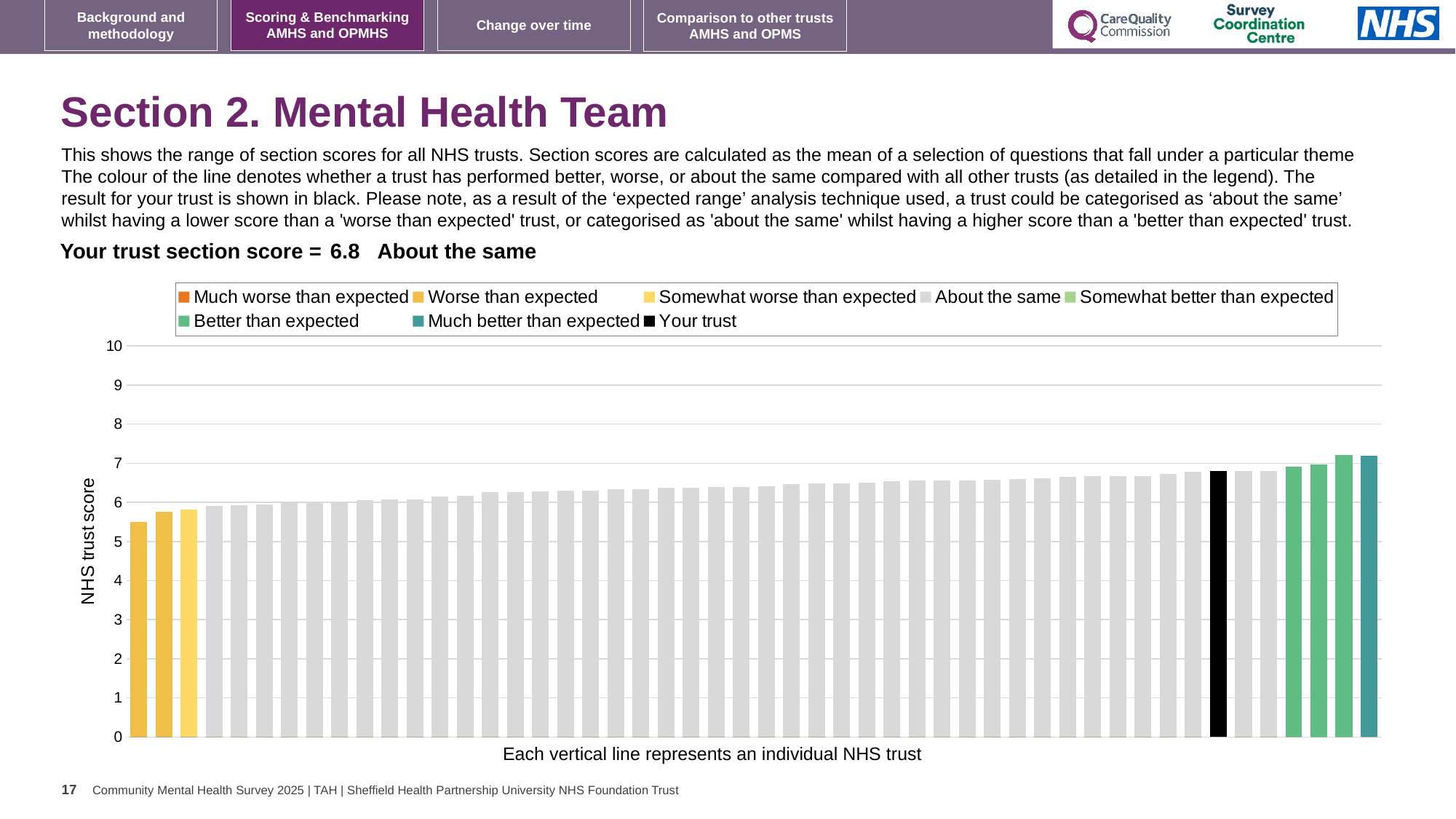
Is the value of the highest bar in the chart greater or less than 7? greater How many bars are coloured as 'Much better than expected'? 1 What is the label on the y axis of the chart? NHS trust score How many bars are coloured as 'Worse than expected'? 2 Is the value of the lowest bar in the chart greater or less than 6? less Which category is your trust placed in for this section? About the same How many entries does the chart legend list? 8 What kind of chart is shown on the slide? bar chart Is the value for your trust (the black bar) greater or less than 6? greater What is the section score for your trust shown on the slide? 6.8 Do the bar values rise or fall from left to right along the x axis? rise